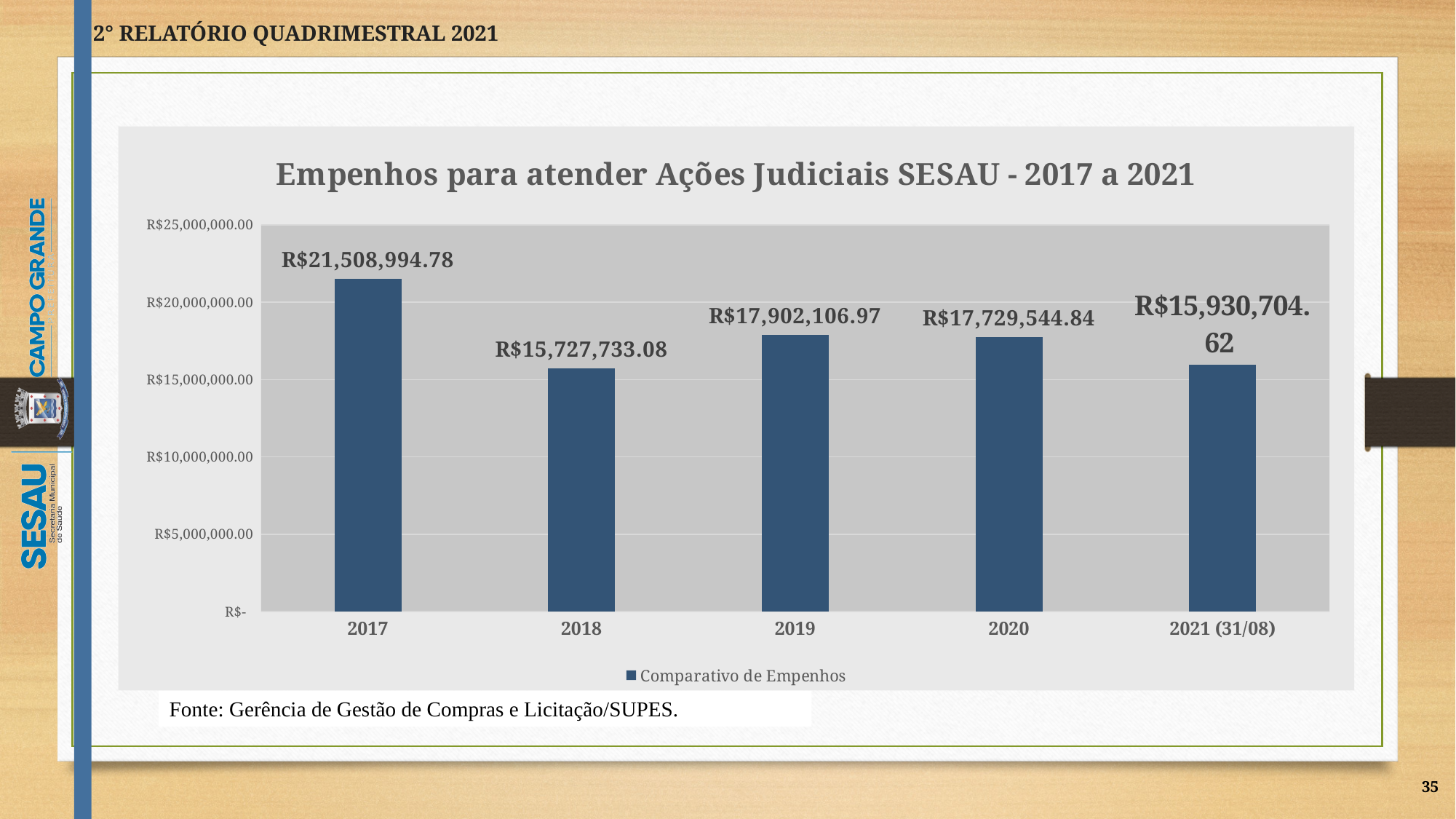
What is the legend entry for the series? Comparativo de Empenhos What type of chart is shown on the slide? Bar chart How many categories are shown on the x axis? 5 What is the difference between the values for 2017 and 2018? R$5,781,261.70 What is the value for 2017? R$21,508,994.78 What is the title of the chart? Empenhos para atender Ações Judiciais SESAU - 2017 a 2021 Which is larger, the value for 2019 or the value for 2020? 2019 Which category has the lowest value? 2018 What is the difference between the values for 2019 and 2020? R$172,562.13 What is the value for 2021 (31/08)? R$15,930,704.62 What is the value for 2018? R$15,727,733.08 Which year has the highest value? 2017